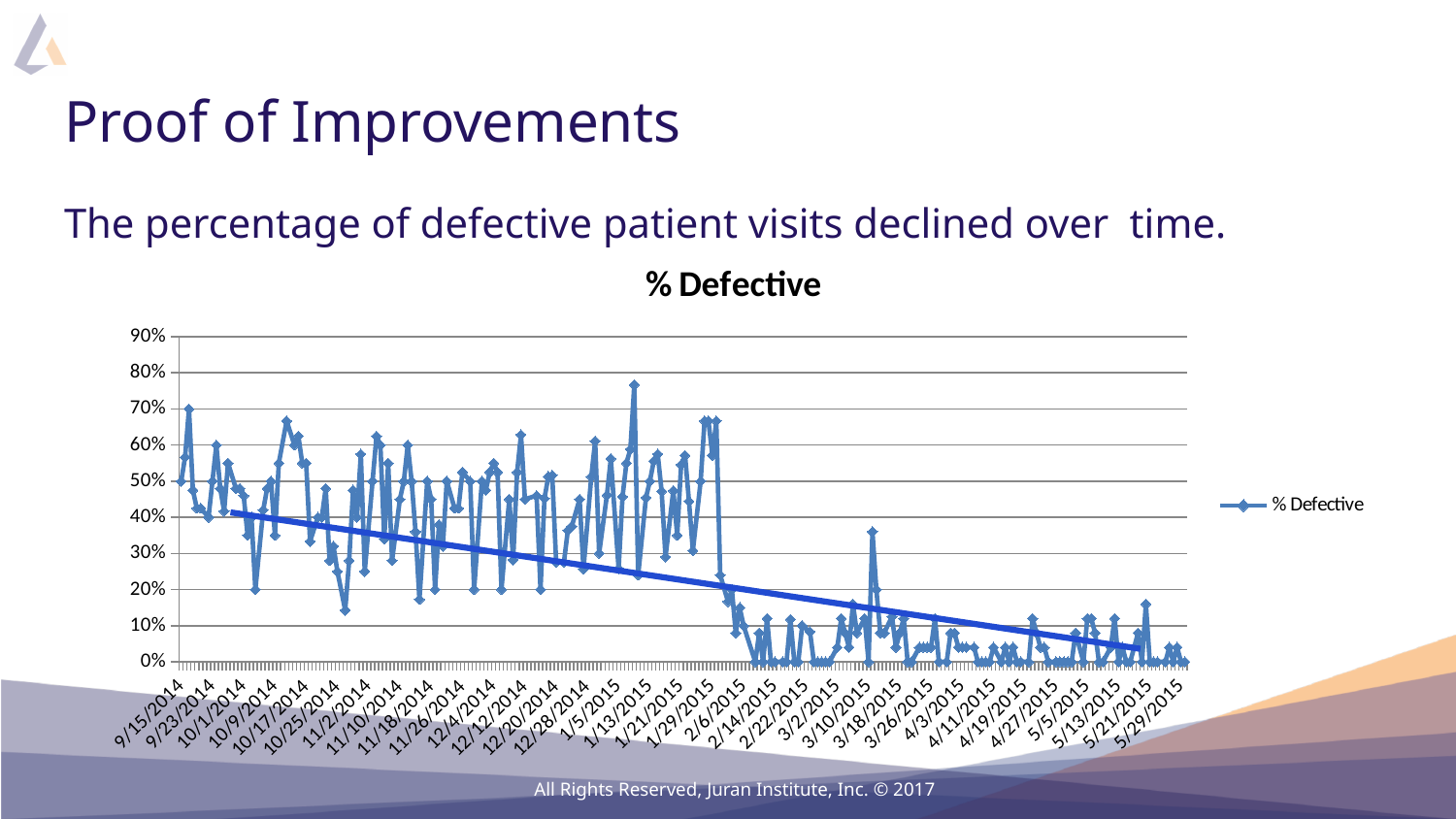
What is the first date label on the x axis? 9/15/2014 Do the % Defective values generally rise or fall over time along the x axis? fall How many series does the chart legend list? 1 What kind of chart is shown on the slide? line chart What is the highest value shown on the y axis? 90% Is the highest value on the chart greater or less than 70%? greater What is the title of the chart? % Defective Is the value for 5/29/2015 greater or less than 10%? less What is the last date label on the x axis? 5/29/2015 How many date labels are printed along the x axis? 33 What is the name of the series shown in the legend? % Defective